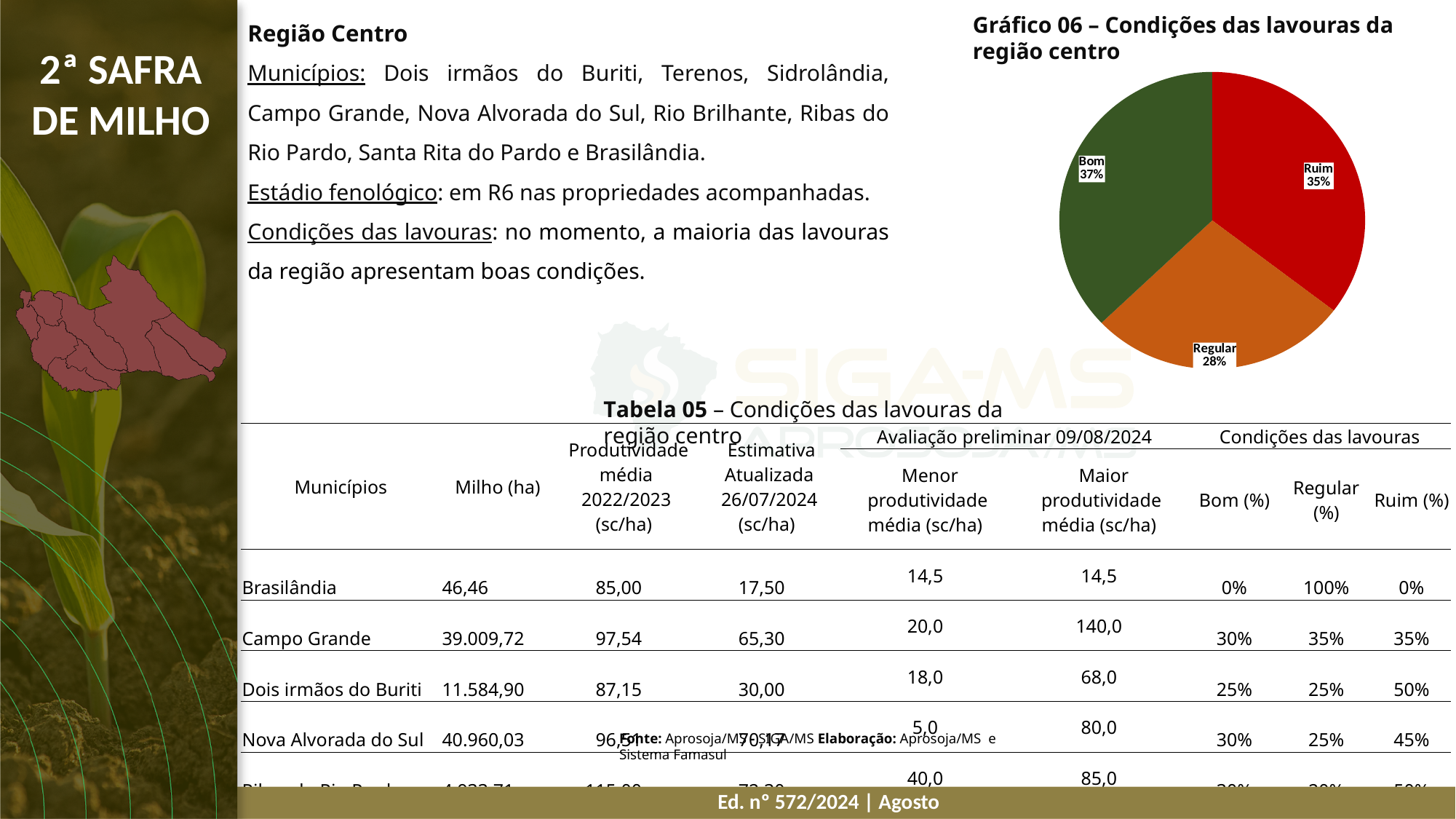
In Gráfico 06, what share of the lavouras is classified as Bom? 37% In Gráfico 06, which condition category has the smallest share? Regular In Gráfico 06, what share of the lavouras is classified as Regular? 28% What is the title of the pie chart on the slide? Gráfico 06 – Condições das lavouras da região centro In Gráfico 06, what share of the lavouras is classified as Ruim? 35% In Gráfico 06, how many slices does the pie chart have? 3 In Gráfico 06, which condition category has the largest share? Bom What kind of chart is Gráfico 06? pie chart In Gráfico 06, what colour is the Ruim slice? red In Gráfico 06, what is the combined share of Bom and Regular? 65% In Gráfico 06, which share is larger, Ruim or Regular? Ruim In Gráfico 06, what is the difference in percentage points between the Bom and Regular shares? 9